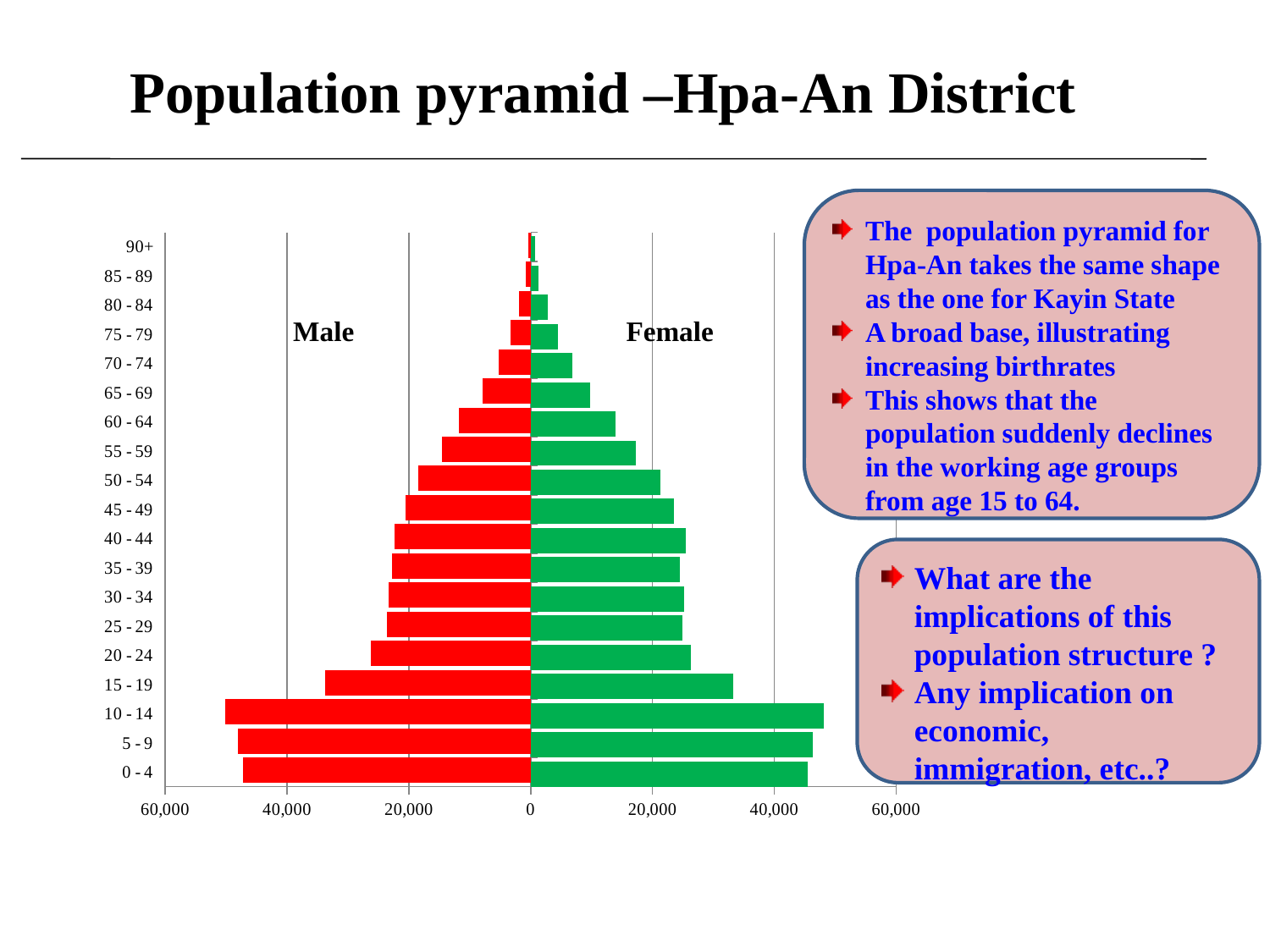
Is the male value for the 10 - 14 age group greater or less than 40,000? greater How many age groups are listed on the vertical axis of the population pyramid? 19 Moving from the youngest age group to the oldest, do the bar lengths generally rise or fall? fall Which age group has the longest male bar in the population pyramid? 10 - 14 What colour are the male bars in the population pyramid? red Is the female value for the 15 - 19 age group greater or less than 40,000? less Which is larger, the female value for the 0 - 4 age group or the female value for the 70 - 74 age group? 0 - 4 Is the female value for the 0 - 4 age group greater or less than 40,000? greater Which is larger, the male value for the 10 - 14 age group or the male value for the 60 - 64 age group? 10 - 14 What kind of chart is shown on the slide? bar chart Which age group has the shortest bars in the population pyramid? 90+